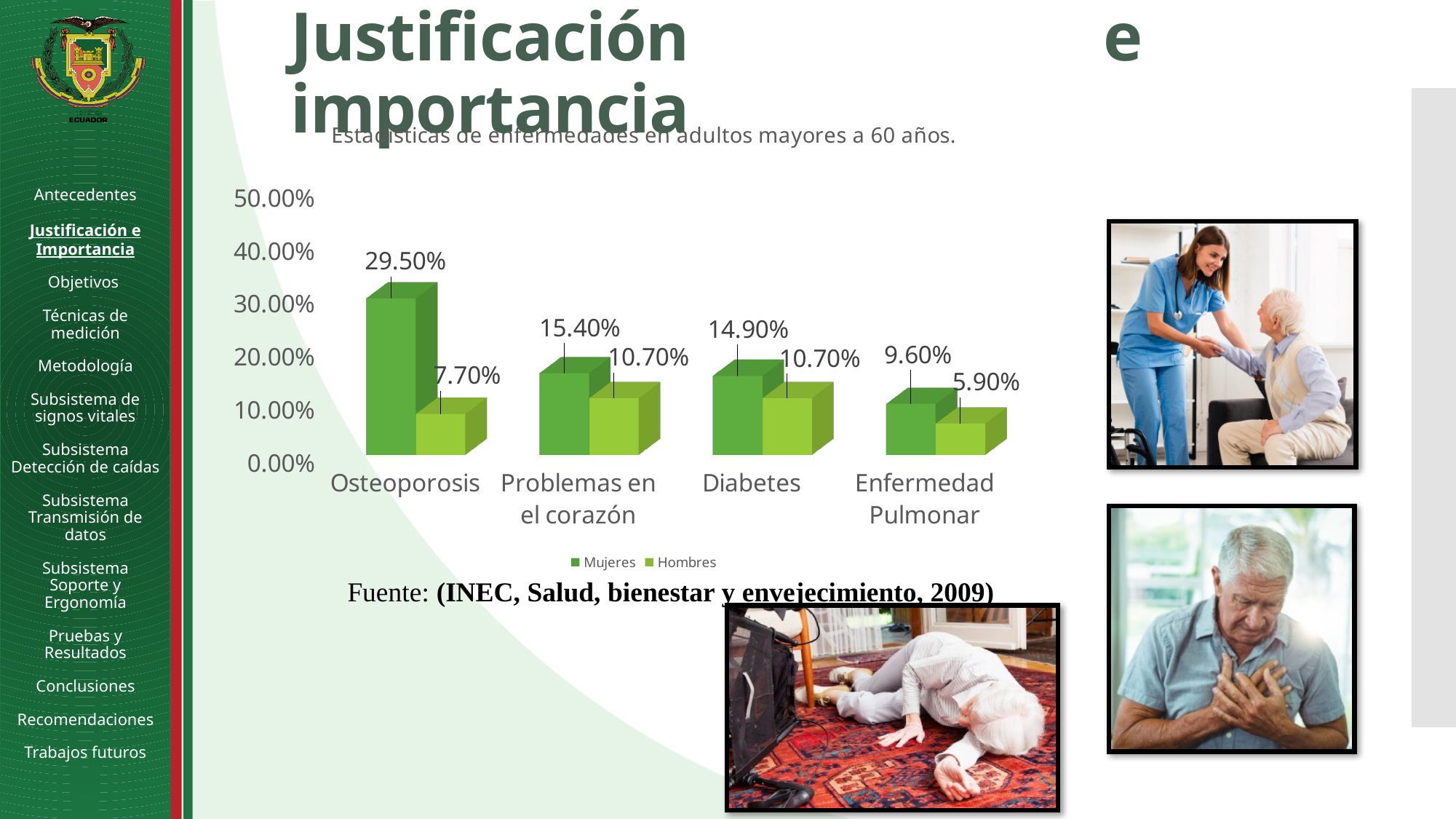
Which is larger for Diabetes, the Mujeres value or the Hombres value? Mujeres What is the difference between the Mujeres and Hombres values for Osteoporosis? 21.80% What is the value for Hombres in the Diabetes category? 10.70% What is the value for Hombres in the Enfermedad Pulmonar category? 5.90% What is the value for Mujeres in the Problemas en el corazón category? 15.40% How many series does the legend list? 2 What kind of chart is shown on the slide? Bar chart How many categories are shown on the x axis? 4 What are the two series named in the legend? Mujeres and Hombres Which category has the lowest value for Hombres? Enfermedad Pulmonar What is the value for Mujeres in the Osteoporosis category? 29.50% Which category has the highest value for Mujeres? Osteoporosis